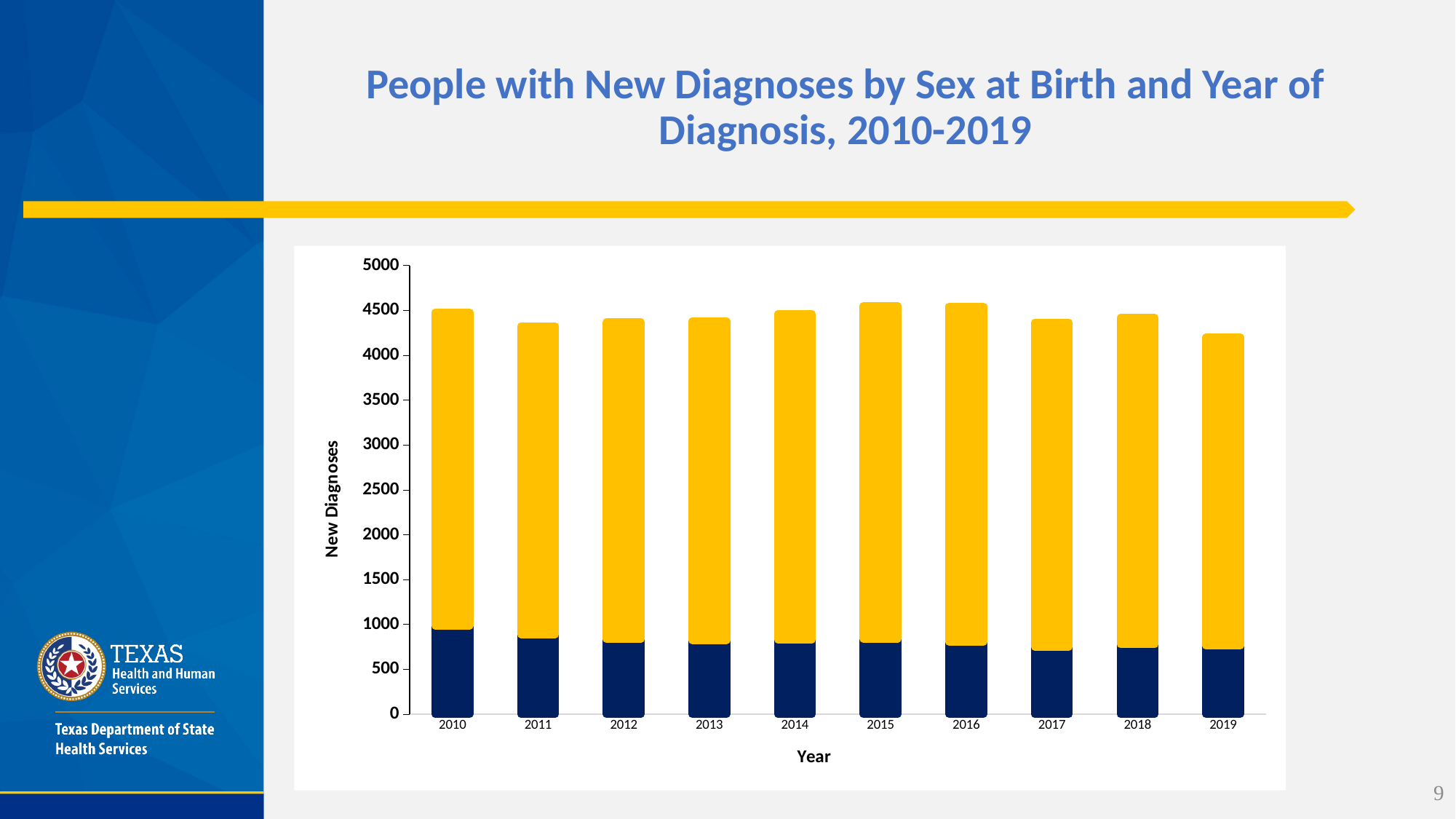
How many years are shown on the x axis of the chart? 10 Is the total bar for 2019 greater or less than 4500? less What kind of chart is shown on the slide? Stacked bar chart Which year has the lowest total bar in the chart? 2019 What is the title of the slide containing the chart? People with New Diagnoses by Sex at Birth and Year of Diagnosis, 2010-2019 Is the total bar for 2015 greater or less than 4500? greater Which year has the larger total bar, 2010 or 2011? 2010 Is the dark blue segment for 2017 greater or less than 500? greater What is the label on the y axis of the chart? New Diagnoses Which year has the larger total bar, 2015 or 2019? 2015